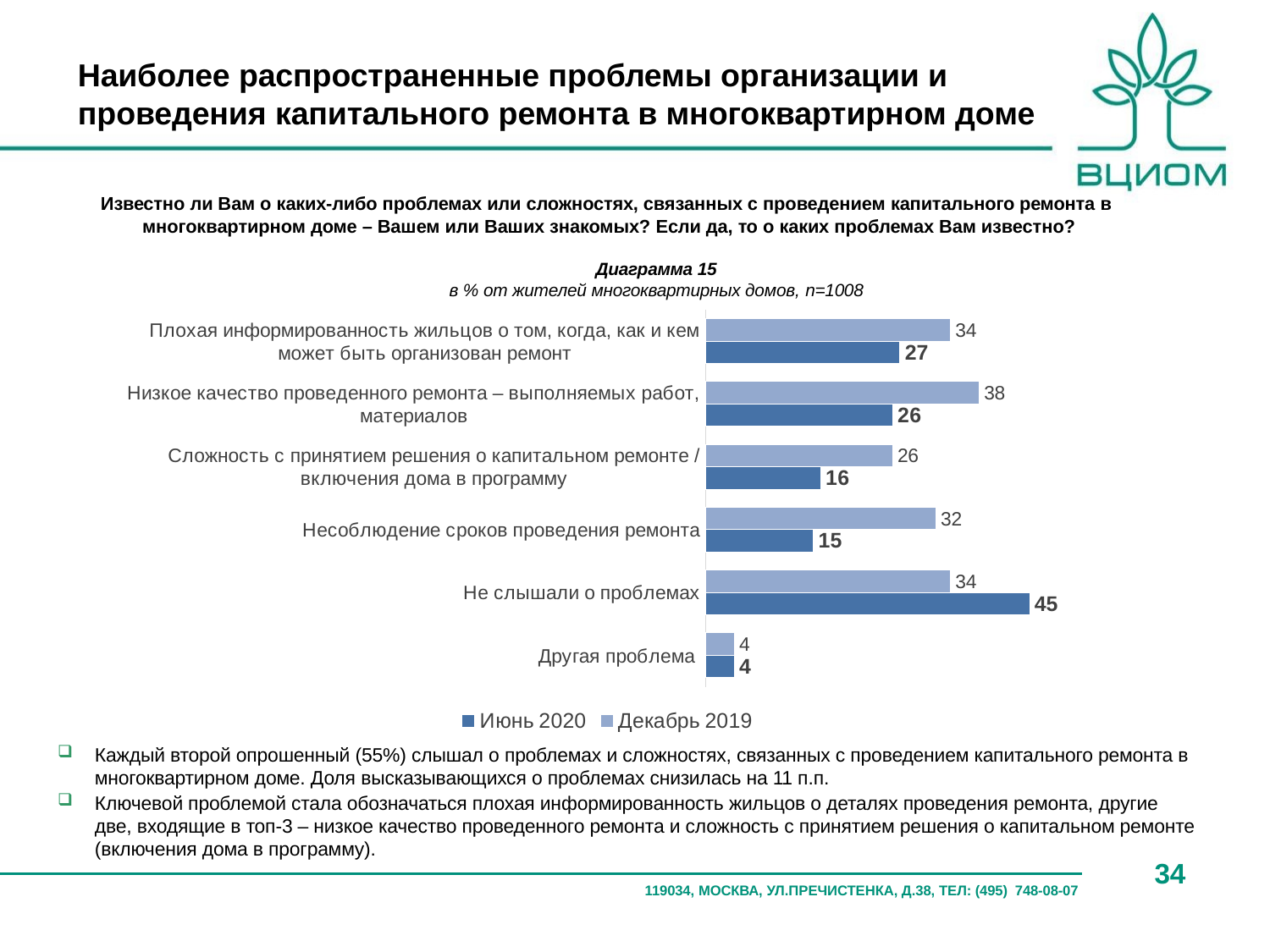
How many categories are shown in the chart? 6 What is the value for "Несоблюдение сроков проведения ремонта" in the Июнь 2020 series? 15 For "Сложность с принятием решения о капитальном ремонте / включения дома в программу", which series has the larger value, Июнь 2020 or Декабрь 2019? Декабрь 2019 What is the difference between the Декабрь 2019 and Июнь 2020 values for "Несоблюдение сроков проведения ремонта"? 17 Which series is shown in dark blue in the legend? Июнь 2020 What is the sample size (n) stated in the chart subtitle? n=1008 What type of chart is shown on the slide? bar chart How many series does the legend list? 2 What is the value for "Низкое качество проведенного ремонта – выполняемых работ, материалов" in the Декабрь 2019 series? 38 Which category has the highest value in the Июнь 2020 series? Не слышали о проблемах What is the value for "Не слышали о проблемах" in the Июнь 2020 series? 45 Which category has the lowest value in the Декабрь 2019 series? Другая проблема